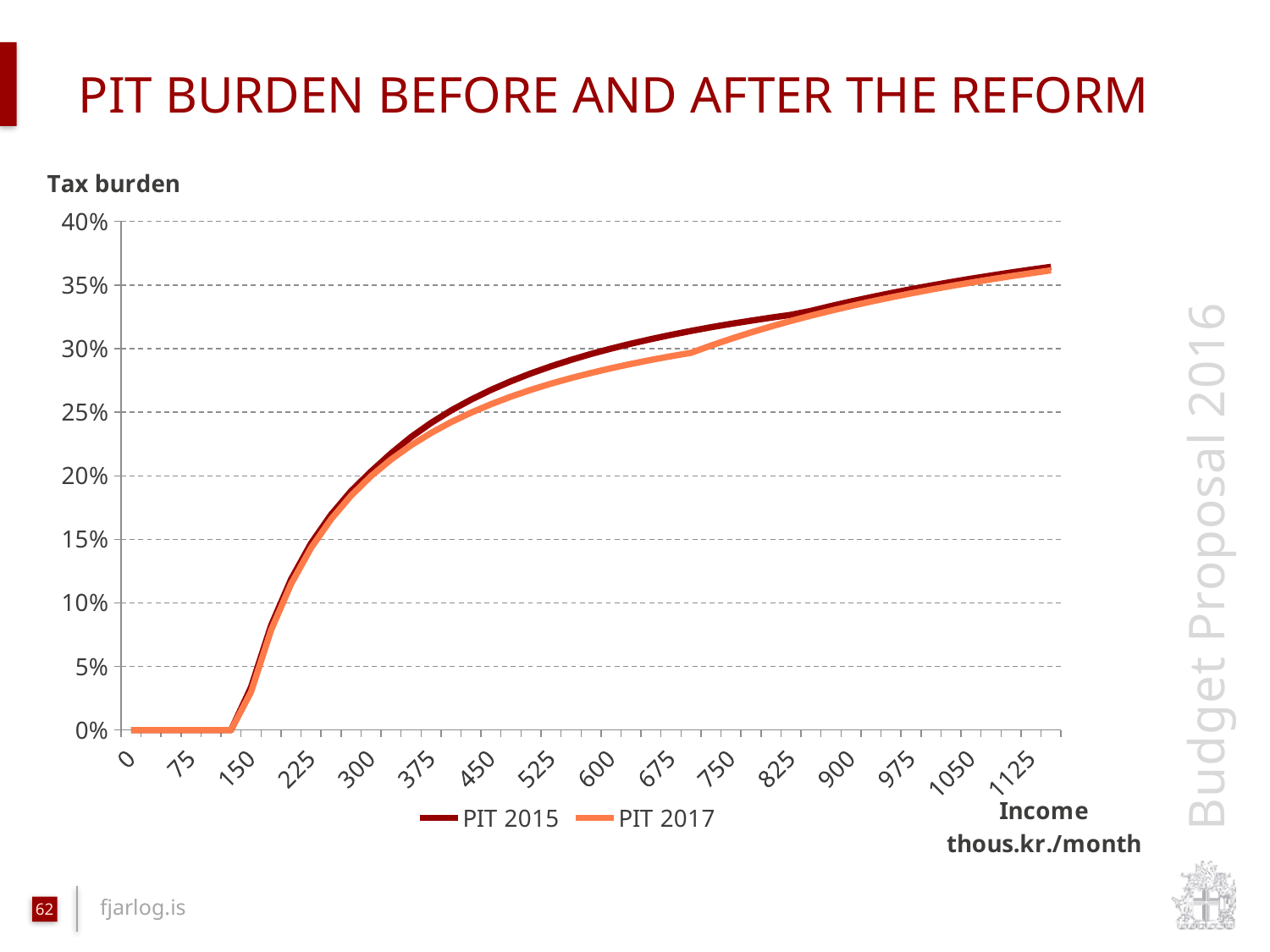
Is the PIT 2017 tax burden at an income of 900 greater or less than 35%? less What are the two series named in the legend? PIT 2015 and PIT 2017 What is the title of the slide? PIT BURDEN BEFORE AND AFTER THE REFORM Is the PIT 2015 tax burden at an income of 750 greater or less than 30%? greater Is the PIT 2017 tax burden at an income of 375 greater or less than 25%? less How many series does the legend list? 2 What kind of chart is shown on the slide? line chart What is the tax burden for PIT 2017 at an income of 75? 0% Do the tax burden values rise or fall as income increases along the x axis? rise What is the tax burden for PIT 2015 at an income of 0? 0% At an income of 675, which series has the higher tax burden, PIT 2015 or PIT 2017? PIT 2015